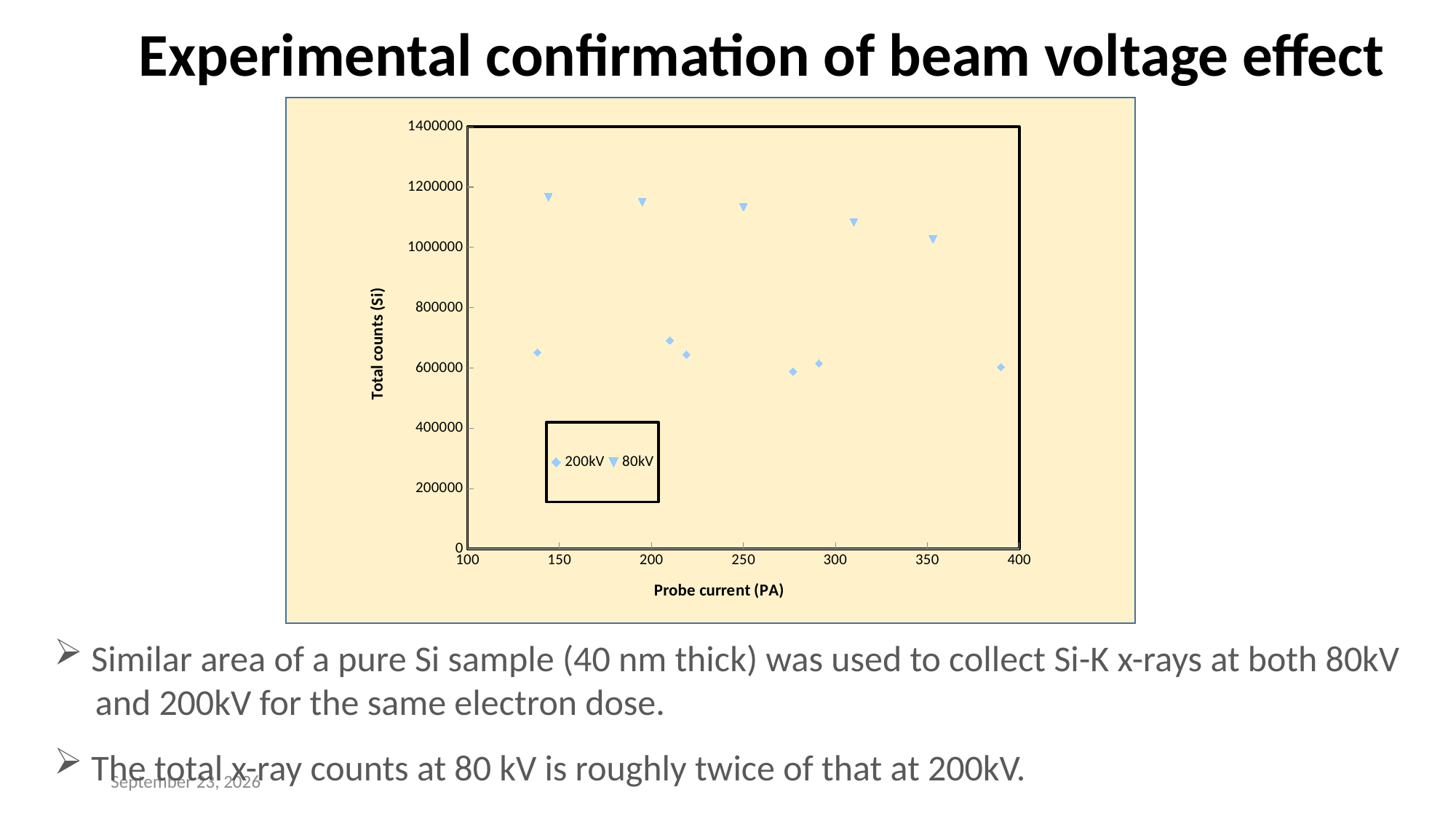
Which series has the higher total counts, 80kV or 200kV? 80kV Is the value for the 80kV point at about 145 pA greater or less than 1000000? greater How many series does the legend list? 2 Are all the 200kV points greater or less than 800000? less Do the 80kV values rise or fall as probe current increases along the x axis? fall What is the label of the x axis? Probe current (PA) Is the value for the 80kV point at about 350 pA greater or less than 1000000? greater How many data points are plotted for the 80kV series? 5 How many data points are plotted for the 200kV series? 6 What is the label of the y axis? Total counts (Si) What kind of chart is shown on the slide? scatter chart